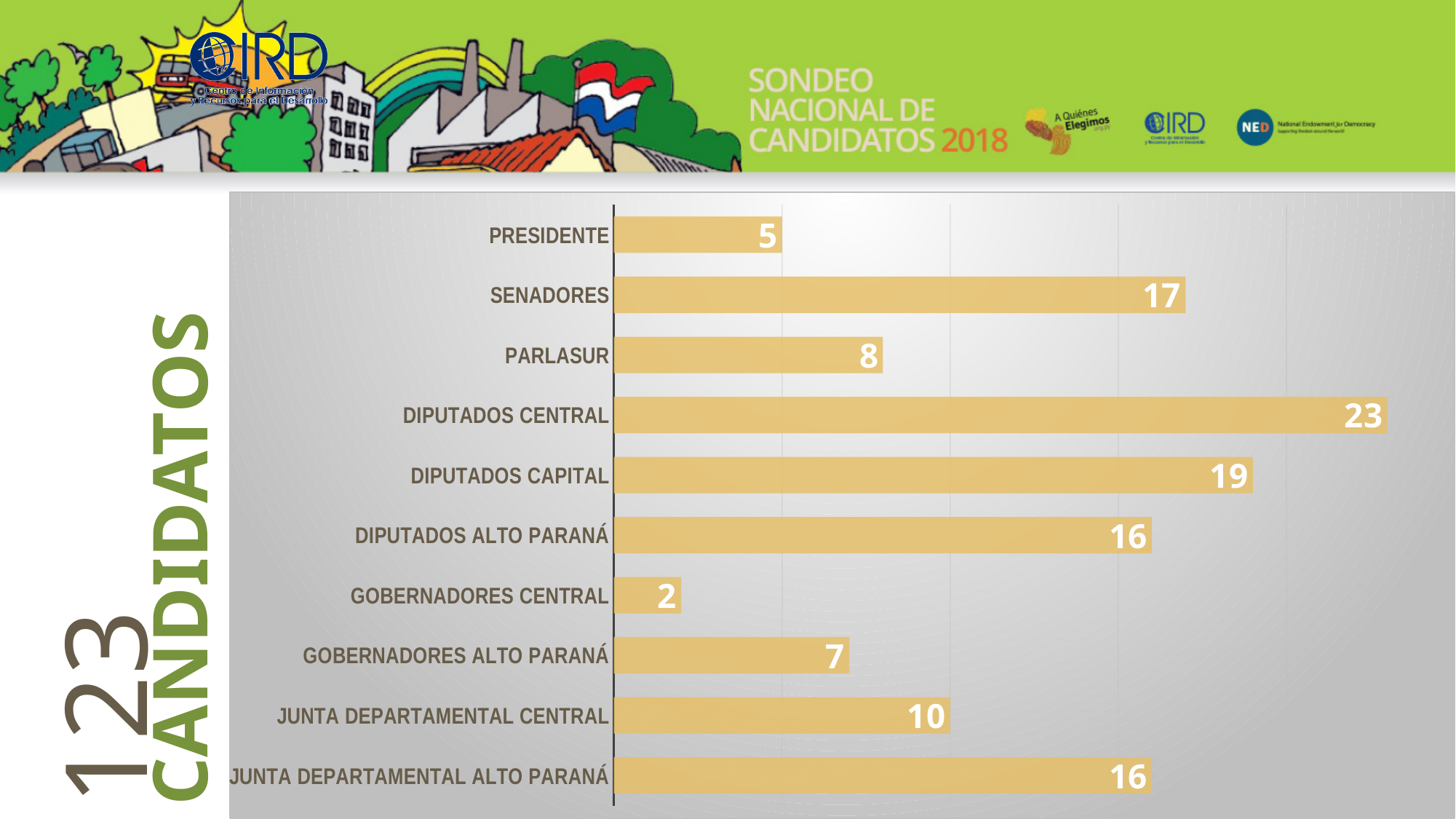
How many categories does the chart show? 10 How many candidates are shown for SENADORES? 17 Which category has the lowest value? GOBERNADORES CENTRAL Which is larger, DIPUTADOS CAPITAL or DIPUTADOS ALTO PARANÁ? DIPUTADOS CAPITAL What is the difference between SENADORES and JUNTA DEPARTAMENTAL CENTRAL? 7 What kind of chart is shown on the slide? Bar chart What is the value for DIPUTADOS CAPITAL? 19 What is the difference between DIPUTADOS CENTRAL and PRESIDENTE? 18 What total number of candidates is stated in the large text on the left of the slide? 123 CANDIDATOS What is the value for GOBERNADORES ALTO PARANÁ? 7 Which category has the highest value? DIPUTADOS CENTRAL Which is larger, PARLASUR or GOBERNADORES ALTO PARANÁ? PARLASUR